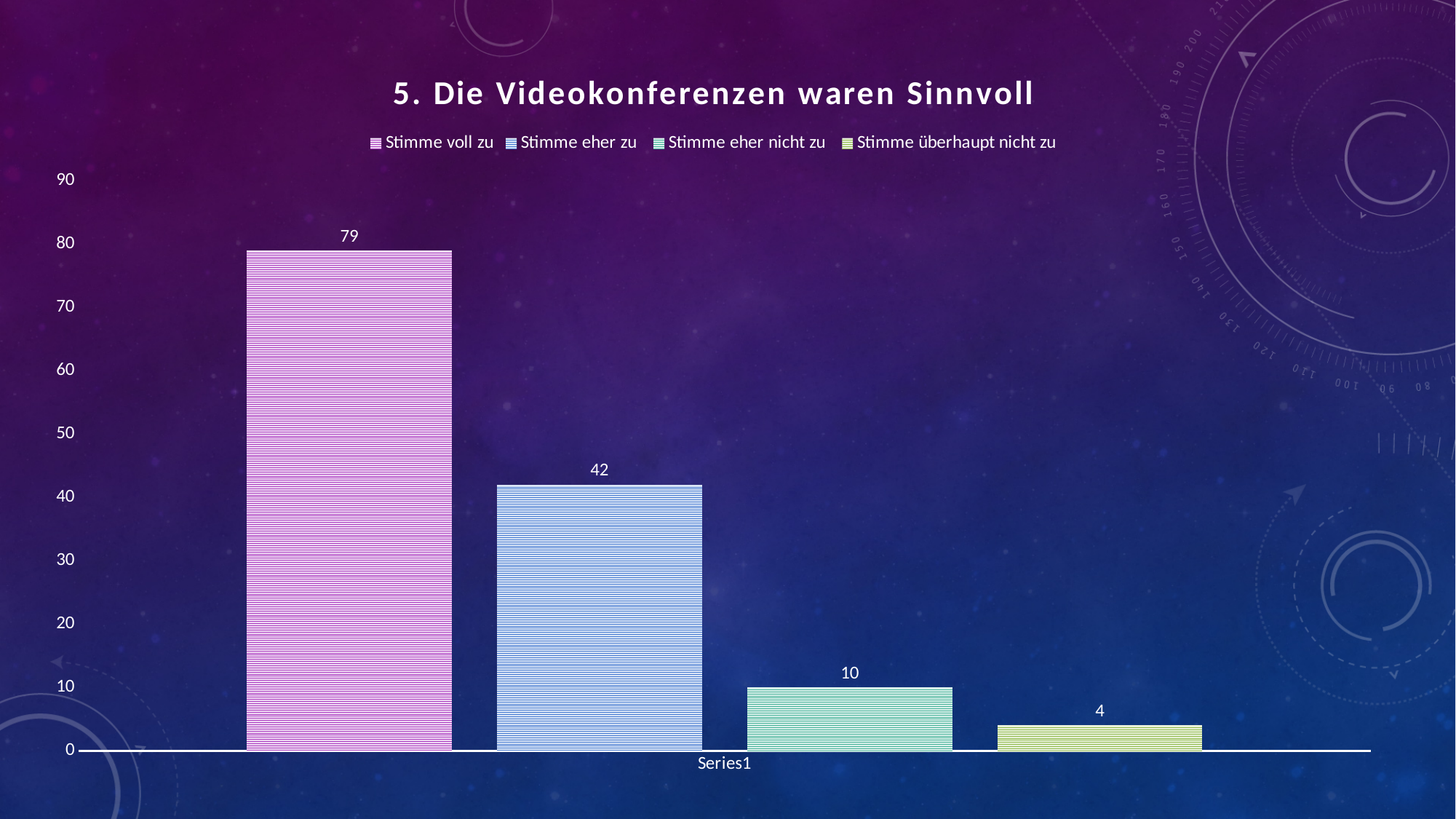
Which series has the lowest value? Stimme überhaupt nicht zu Which series has the highest value? Stimme voll zu Which is larger, the value for "Stimme eher nicht zu" or "Stimme überhaupt nicht zu"? Stimme eher nicht zu What is the difference between the values for "Stimme voll zu" and "Stimme eher zu"? 37 What is the value for "Stimme voll zu"? 79 What is the value for "Stimme überhaupt nicht zu"? 4 What is the label shown on the x axis below the bars? Series1 What kind of chart is shown on the slide? Bar chart How many series does the legend list? 4 What is the value for "Stimme eher zu"? 42 What is the title of the chart? 5. Die Videokonferenzen waren Sinnvoll What is the value for "Stimme eher nicht zu"? 10